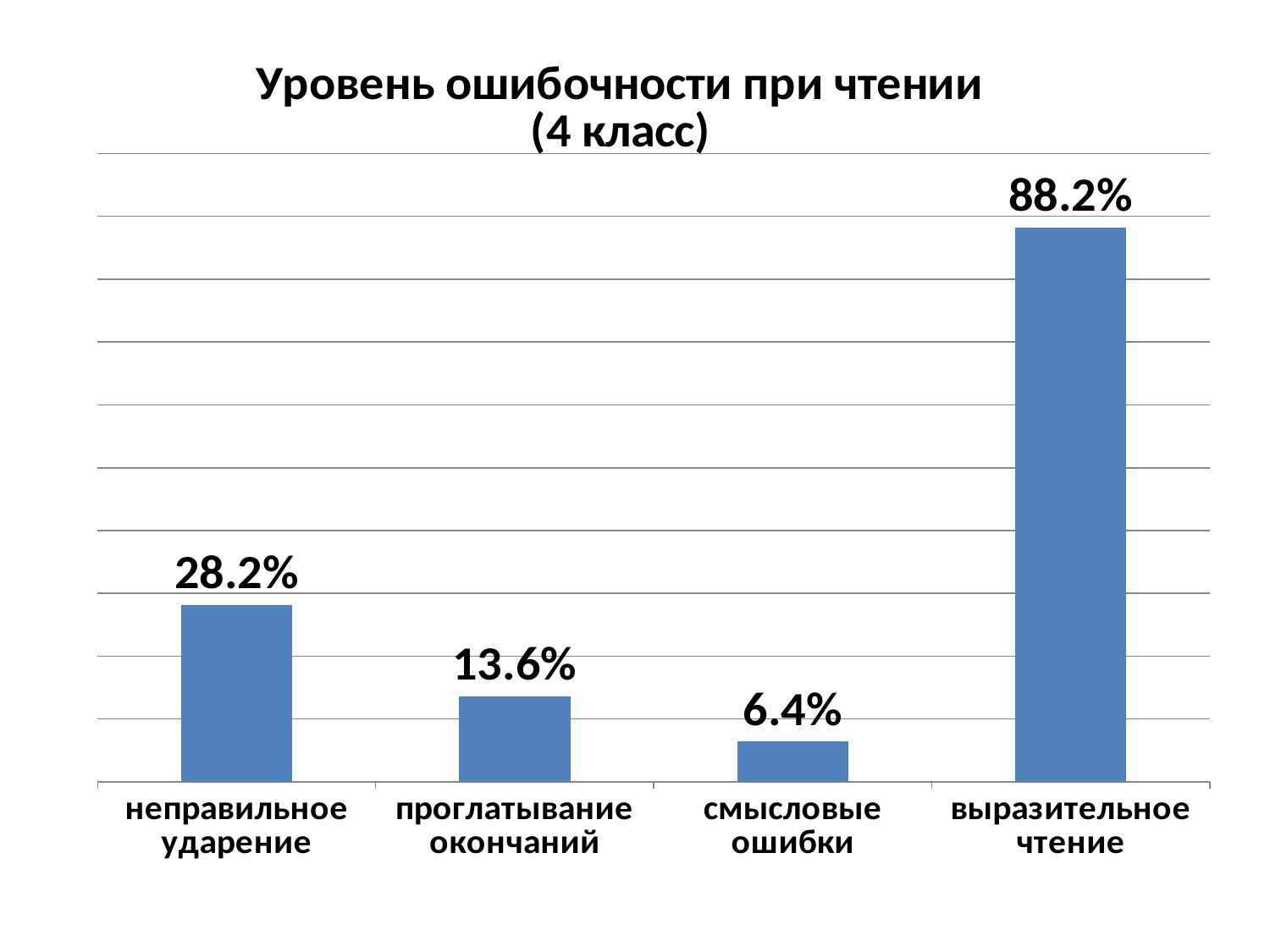
What is the title of the chart? Уровень ошибочности при чтении (4 класс) What is the value for проглатывание окончаний? 13.6% What is the difference between the values for неправильное ударение and проглатывание окончаний? 14.6% What is the difference between the values for выразительное чтение and неправильное ударение? 60.0% What kind of chart is this? bar chart What is the value for неправильное ударение? 28.2% What is the value for выразительное чтение? 88.2% Which category has the highest value? выразительное чтение What is the value for смысловые ошибки? 6.4% Which is larger, the value for проглатывание окончаний or the value for смысловые ошибки? проглатывание окончаний How many categories are shown in the chart? 4 Which category has the lowest value? смысловые ошибки